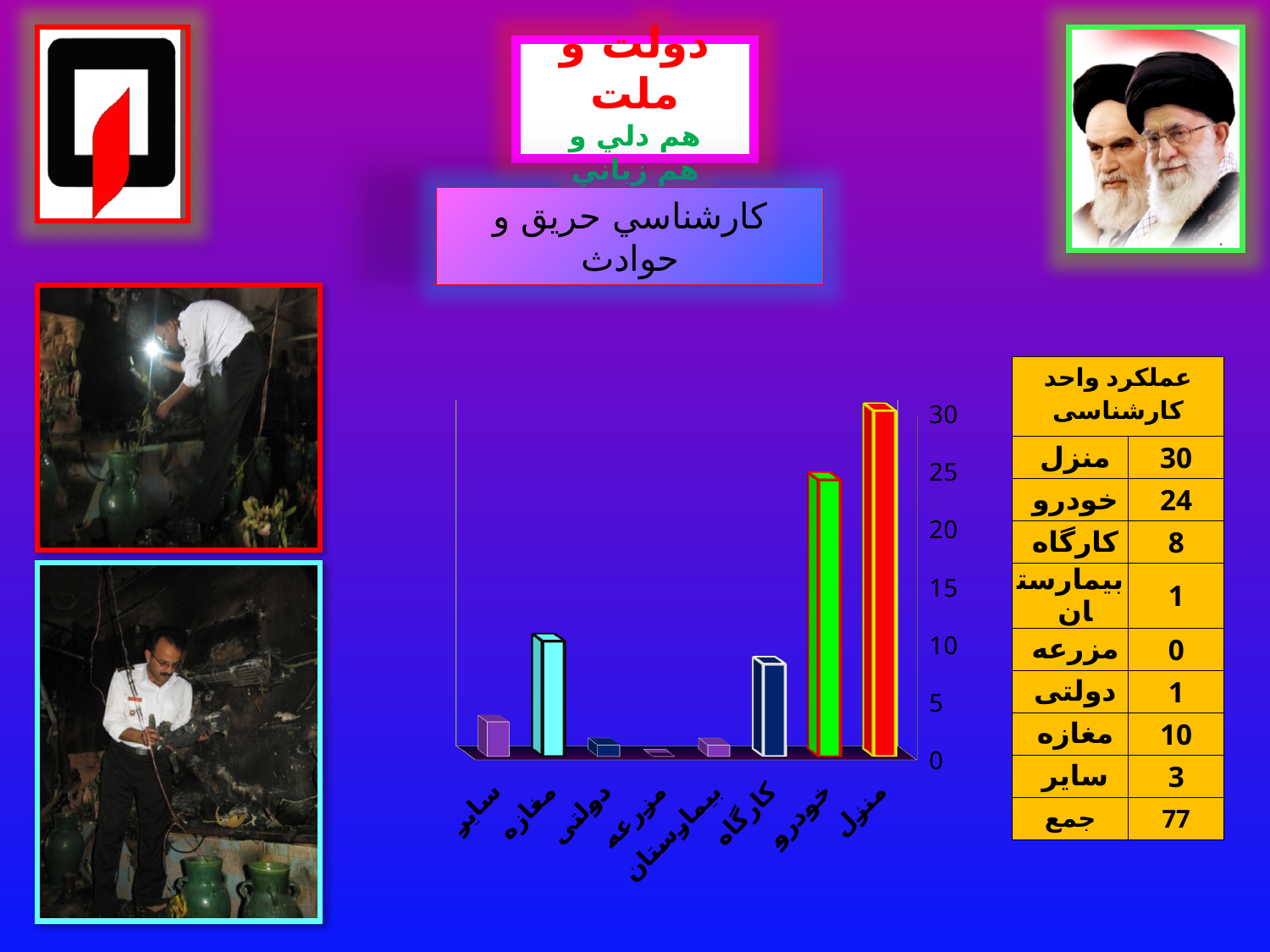
What is the value for خودرو according to the table beside the chart? 24 How many categories are plotted on the x axis of the chart? 8 Is the value for کارگاه greater or less than 10? less What is the difference between the values for منزل and خودرو? 6 Which is larger, the value for خودرو or the value for کارگاه? خودرو What is the highest tick value shown on the chart's vertical axis? 30 What is the value for مغازه according to the table beside the chart? 10 What kind of chart is shown on the slide? bar chart Is the value for خودرو greater or less than 20? greater Which category has the lowest value in the chart? مزرعه What is the value for منزل? 30 Which category has the highest bar in the chart? منزل